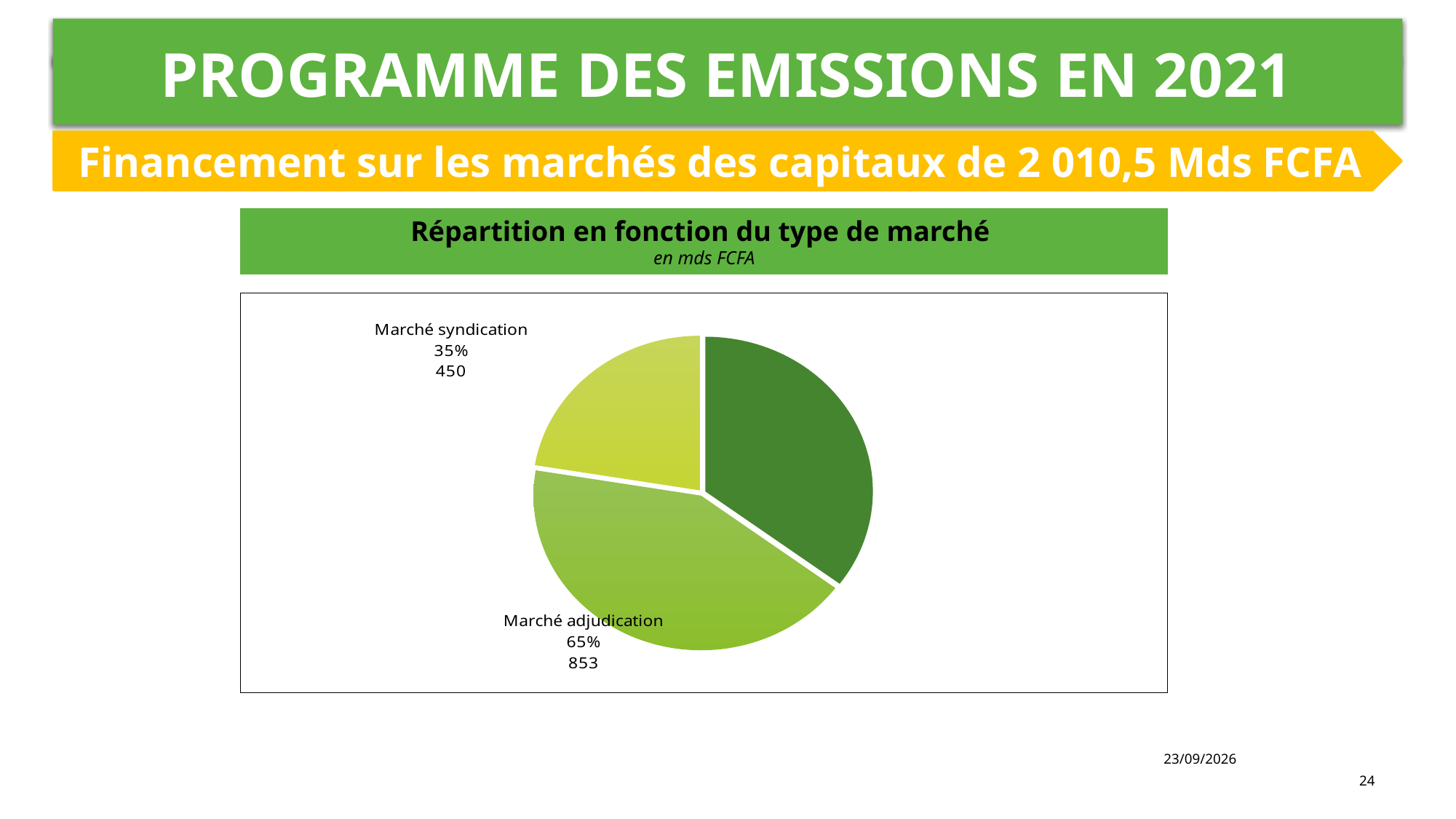
In what unit are the chart values expressed, according to the chart subtitle? en mds FCFA What share of the pie is labelled for Marché syndication? 35% What is the title of the chart? Répartition en fonction du type de marché What share of the pie is labelled for Marché adjudication? 65% What is the difference between the values for Marché adjudication and Marché syndication? 403 What type of chart is shown on the slide? pie chart Which is larger, Marché adjudication or Marché syndication? Marché adjudication What is the value shown for Marché syndication? 450 What is the value shown for Marché adjudication? 853